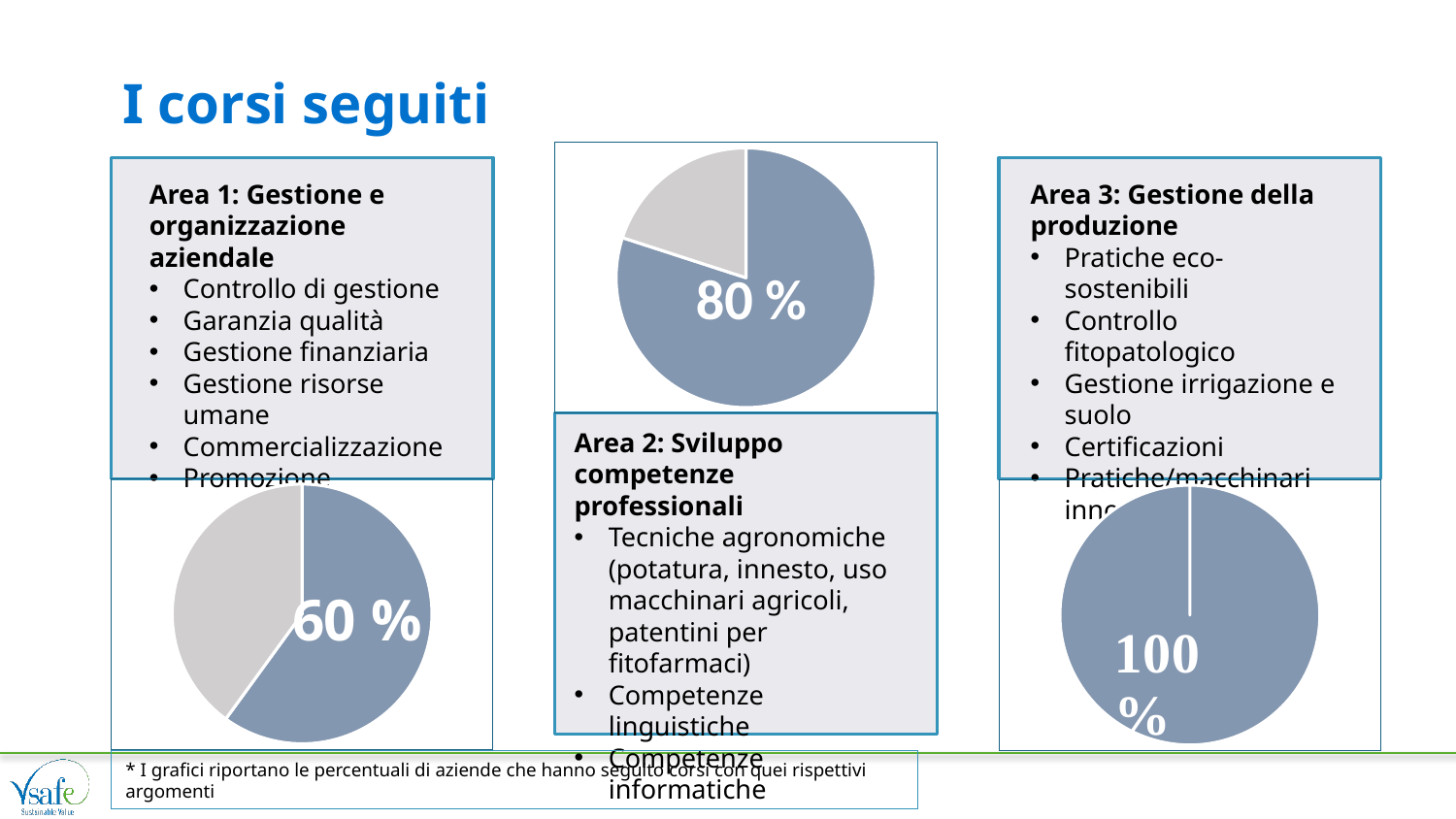
In the pie chart below Area 1 (left side of the slide), what percentage is shown on the labelled slice? 60 % How many pie charts are on the slide? 3 Which pie chart shows a larger percentage, the one for Area 1 or the one for Area 2? Area 2 In the pie chart below Area 3 (right side of the slide), what percentage is shown? 100 % Which area's pie chart shows the lowest percentage? Area 1 (60 %) What is the difference between the percentage in the middle pie chart (Area 2) and the left pie chart (Area 1)? 20 percentage points In the middle pie chart (Area 2), what share of the pie does the unlabelled grey slice represent? 20 % In the pie chart above Area 2 (middle of the slide), what percentage is shown on the labelled slice? 80 % What type of chart is used on this slide to show the percentages for each area? Pie chart What colour is the labelled slice in each of the pie charts? Blue Which area's pie chart shows the highest percentage? Area 3 (100 %) What is the difference between the percentage in the right pie chart (Area 3) and the left pie chart (Area 1)? 40 percentage points